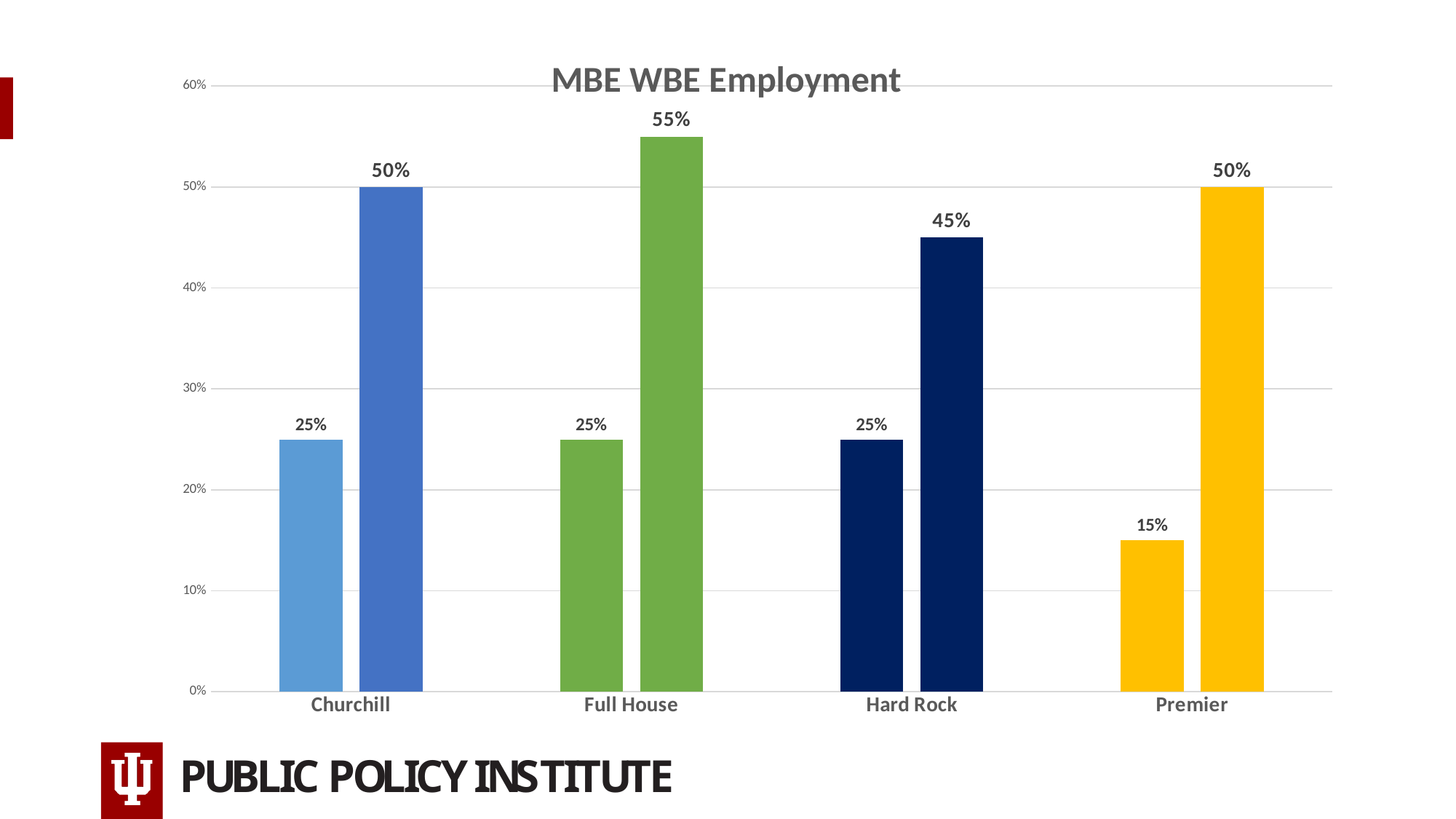
How many categories are shown on the x axis? 4 What is the title of the chart? MBE WBE Employment Which category has the highest bar in the chart? Full House What is the value of the second (taller) bar for Full House? 55% What is the difference between the second bar for Full House and the second bar for Hard Rock? 10% Which is larger, the second bar for Churchill or the second bar for Hard Rock? Churchill What kind of chart is shown on the slide? bar chart What is the difference between the two bars for Premier? 35% What is the value of the first bar for Churchill? 25% What is the value of the first (shorter) bar for Premier? 15% Which category has the lowest bar in the chart? Premier What is the value of the second bar for Hard Rock? 45%